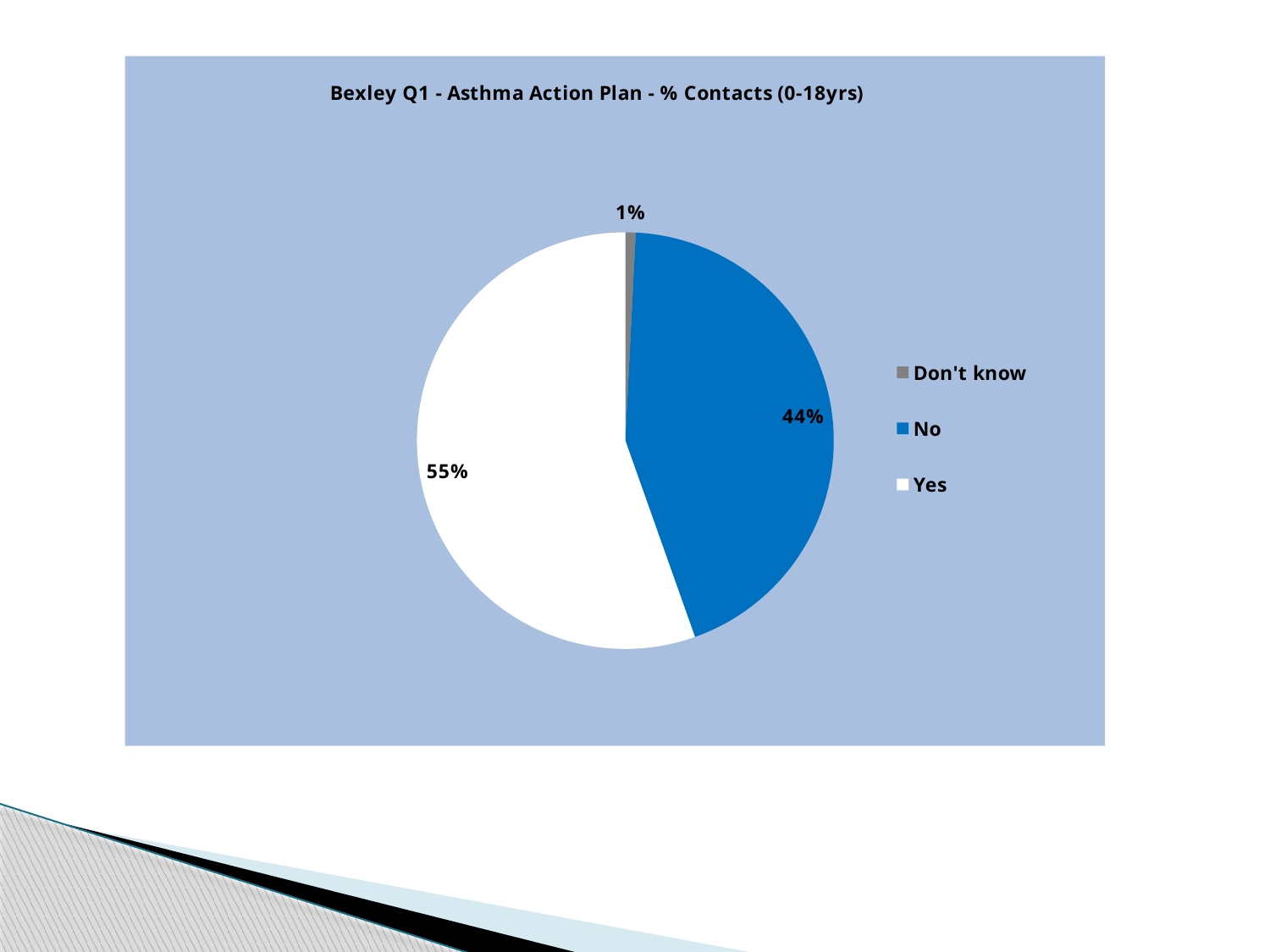
What kind of chart is shown on the slide? pie chart What colour is the slice for No? blue What is the combined share of Yes and No? 99% Which category has the largest share of the pie? Yes What is the title of the chart? Bexley Q1 - Asthma Action Plan - % Contacts (0-18yrs) What percentage of contacts answered Yes? 55% What percentage of contacts answered No? 44% How many categories does the legend list? 3 What percentage of contacts answered Don't know? 1% What is the difference in percentage points between Yes and No? 11 Which is larger, the share for No or the share for Don't know? No Which category has the smallest share of the pie? Don't know